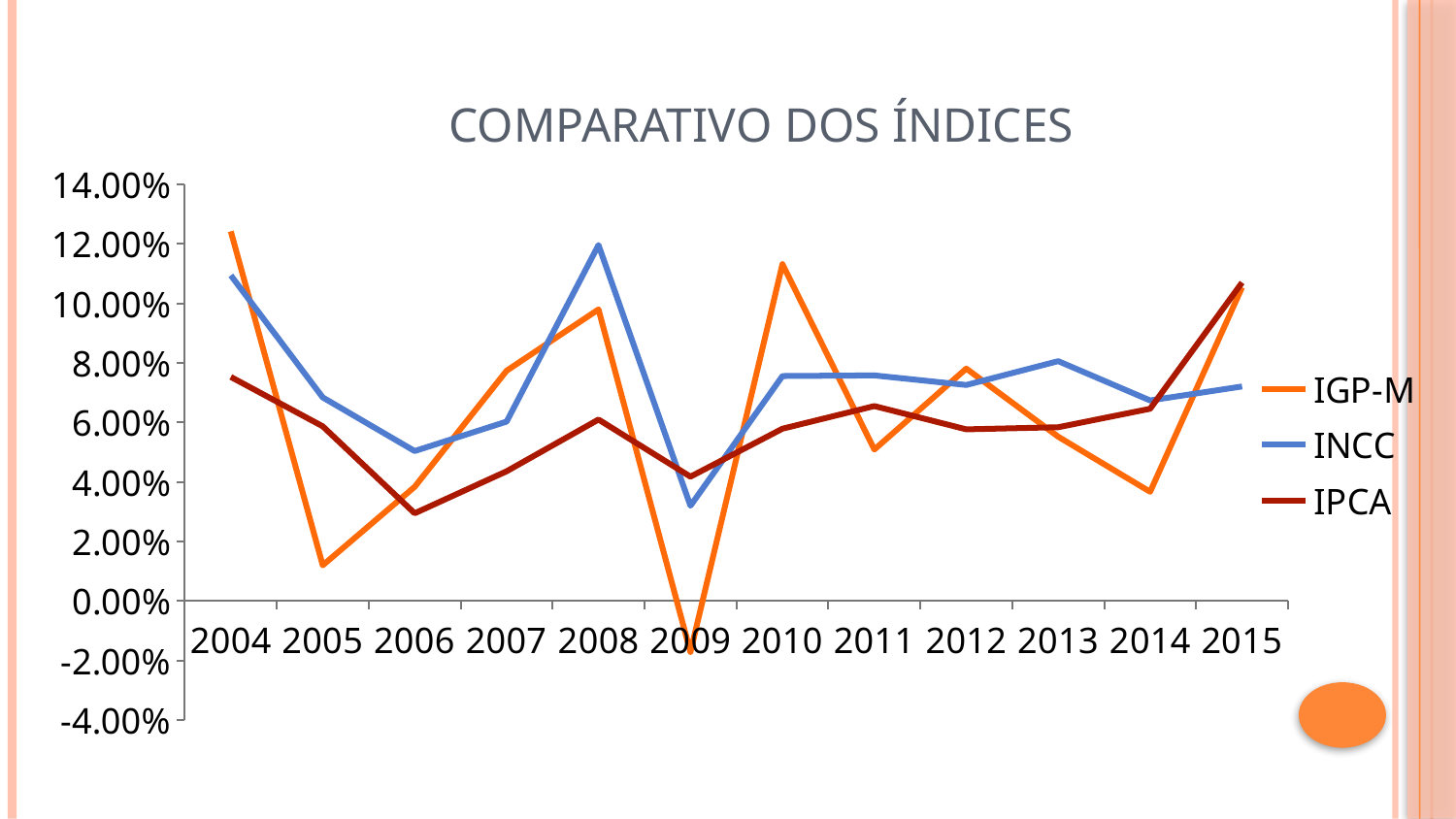
In 2010, which series has the higher value, IGP-M or INCC? IGP-M In 2009, which series has the higher value, INCC or IPCA? IPCA In which year does the INCC series reach its highest value? 2008 Is the IGP-M value for 2005 greater or less than 2.00%? less Is the IGP-M value for 2009 greater or less than 0.00%? less How many series does the legend list? 3 What is the title of the chart? COMPARATIVO DOS ÍNDICES Is the INCC value for 2008 greater or less than 10.00%? greater In which year does the IGP-M series reach its highest value? 2004 In which year does the IGP-M series reach its lowest value? 2009 What type of chart is shown on the slide? Line chart How many years are shown on the x axis? 12